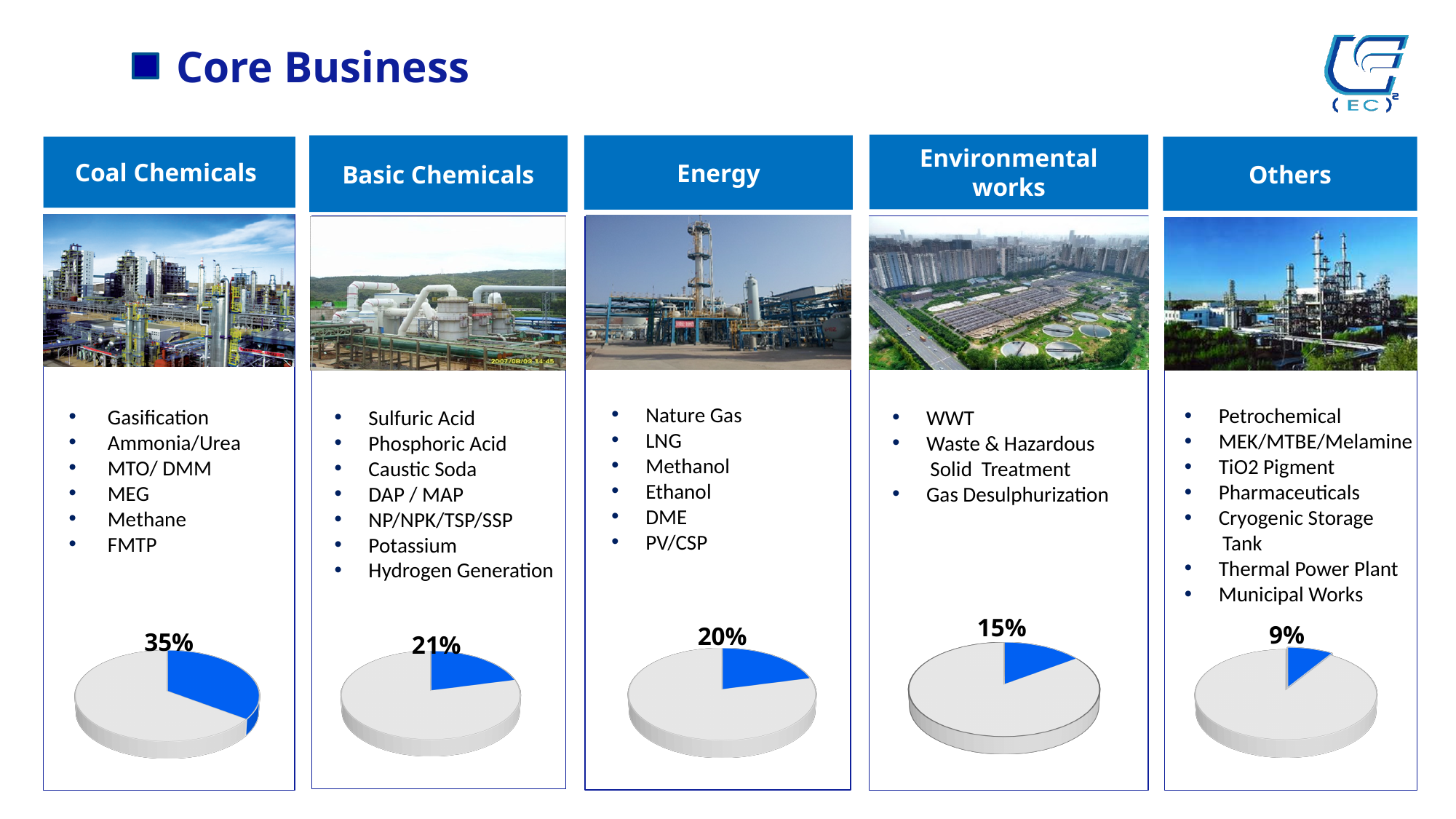
What share is shown on the pie chart under the Basic Chemicals column? 21% What share is shown on the pie chart under the Energy column? 20% What is the difference between the share shown for Coal Chemicals and the share shown for Others? 26% What share is shown on the pie chart under the Environmental works column? 15% What share is shown on the pie chart under the Coal Chemicals column? 35% What colour is the highlighted slice in each pie chart? Blue What share is shown on the pie chart under the Others column? 9% Which business segment's pie chart shows the smallest share? Others Which business segment's pie chart shows the largest share? Coal Chemicals What kind of chart is used under each business column on the slide? Pie chart Which has the larger share on its pie chart, Energy or Environmental works? Energy How many pie charts are on the slide? 5